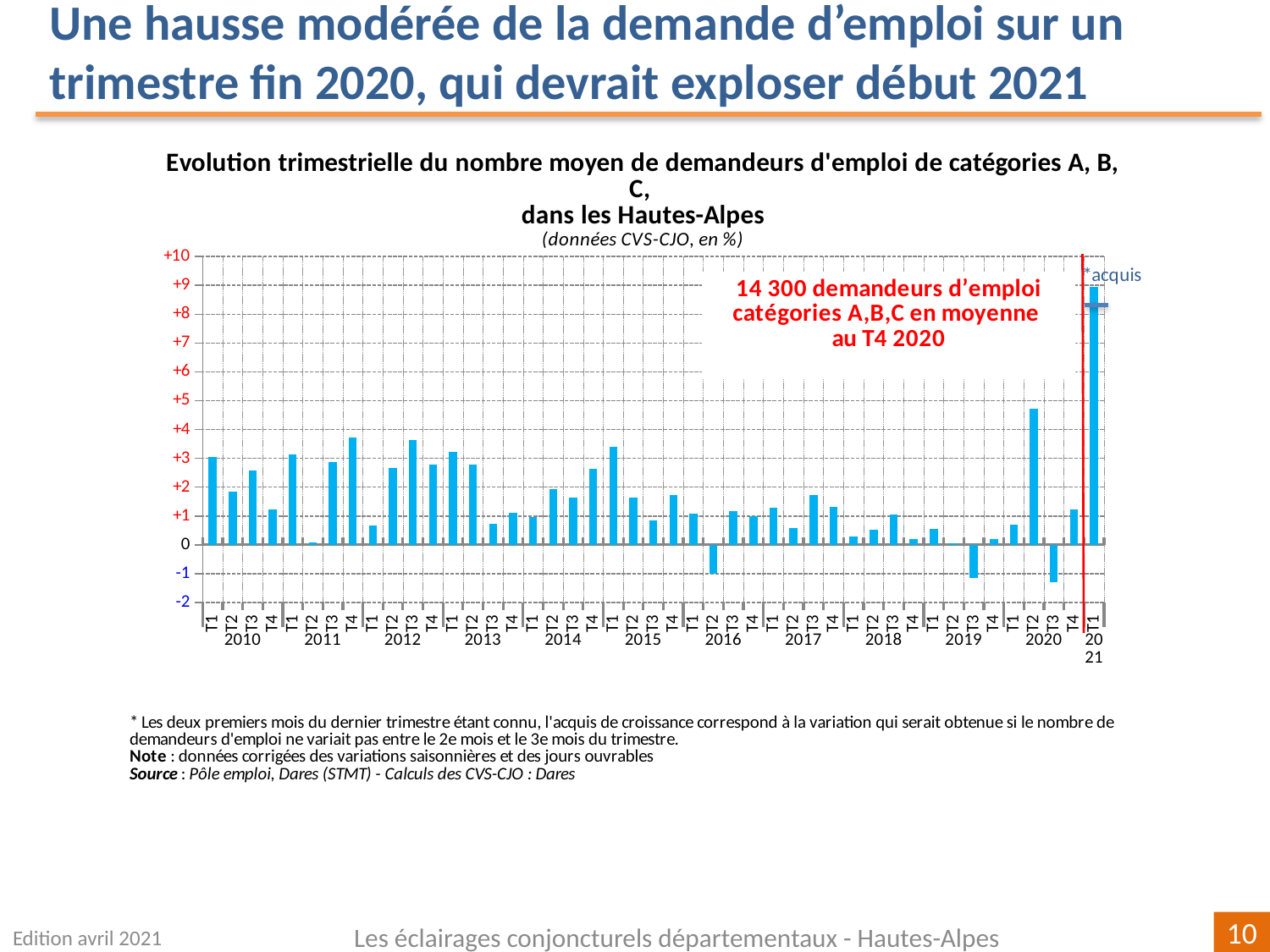
Which quarter has the highest value in the chart? T1 2021 In what unit are the chart's data expressed, according to the subtitle? en % Which is larger, the value for T2 2020 or the value for T4 2020? T2 2020 What kind of chart is shown on the slide? bar chart Is the value for T4 2011 greater or less than +3? greater Is the value for T3 2013 greater or less than +1? less According to the red annotation on the chart, how many demandeurs d'emploi catégories A,B,C were there on average in T4 2020? 14 300 Is the value for T3 2020 greater or less than 0? less Which is larger, the value for T1 2010 or the value for T4 2010? T1 2010 How many years are labelled along the x axis of the chart? 12